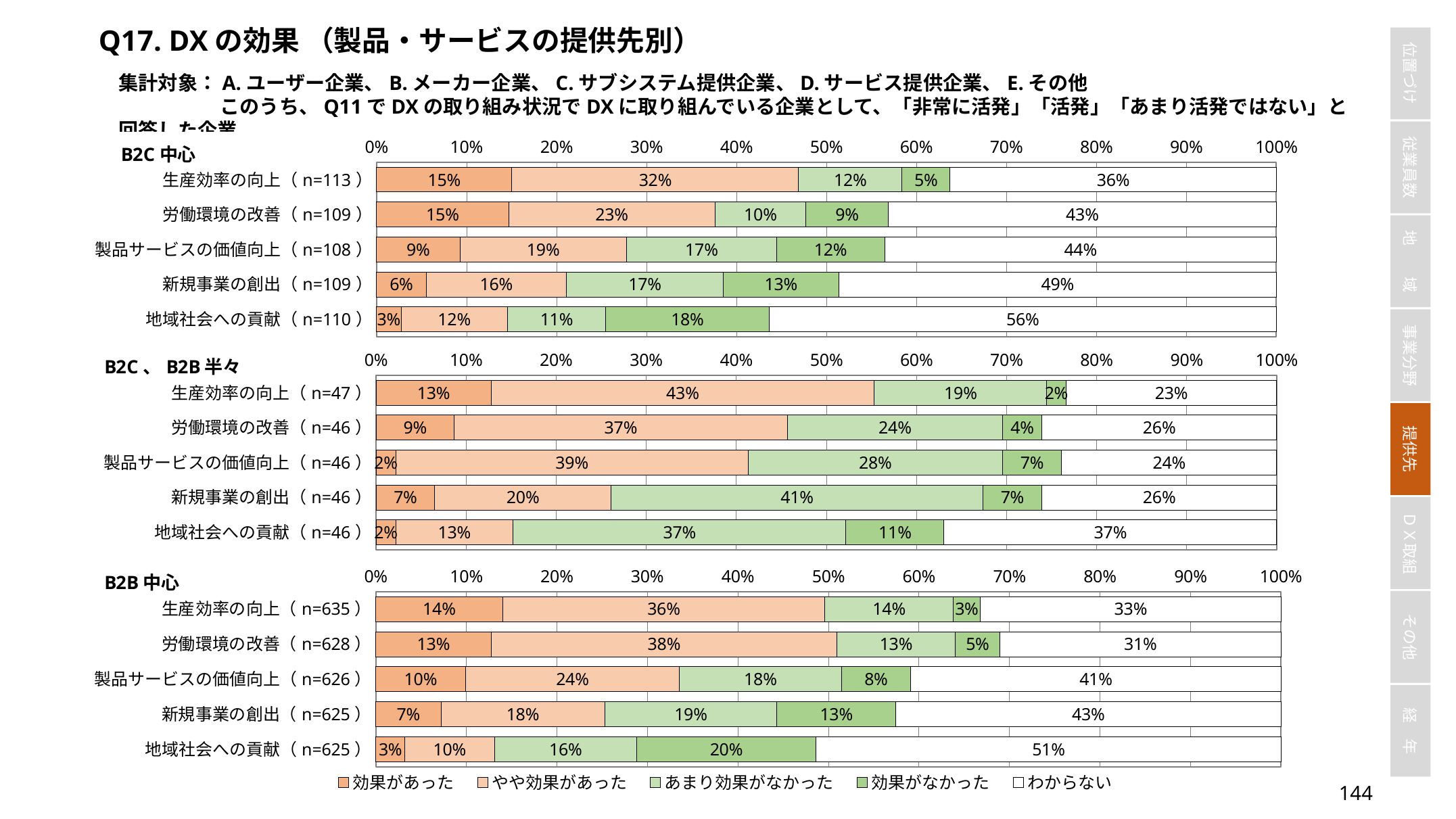
In the B2C中心 chart, which category has the highest わからない value? 地域社会への貢献 In the B2C、B2B半々 chart, what is the あまり効果がなかった value for 新規事業の創出 (n=46)? 41% How many series does the legend at the bottom of the slide list? 5 In the B2B中心 chart, which category has the lowest 効果があった value? 地域社会への貢献 How many categories are plotted in the B2C中心 chart? 5 What kind of chart is used for the B2B中心 section? Stacked bar chart In the B2B中心 chart, which has the larger やや効果があった value: 労働環境の改善 or 製品サービスの価値向上? 労働環境の改善 In the B2B中心 chart, what is the わからない value for 地域社会への貢献 (n=625)? 51% In the B2B中心 chart, what is the sample size (n) shown for 生産効率の向上? n=635 In the B2C中心 chart, what is the 効果があった value for 生産効率の向上 (n=113)? 15% In the B2C、B2B半々 chart, what is the difference between the やや効果があった values for 生産効率の向上 (43%) and 労働環境の改善 (37%)? 6 percentage points In the B2C、B2B半々 chart, what is the 効果がなかった value for 地域社会への貢献 (n=46)? 11%